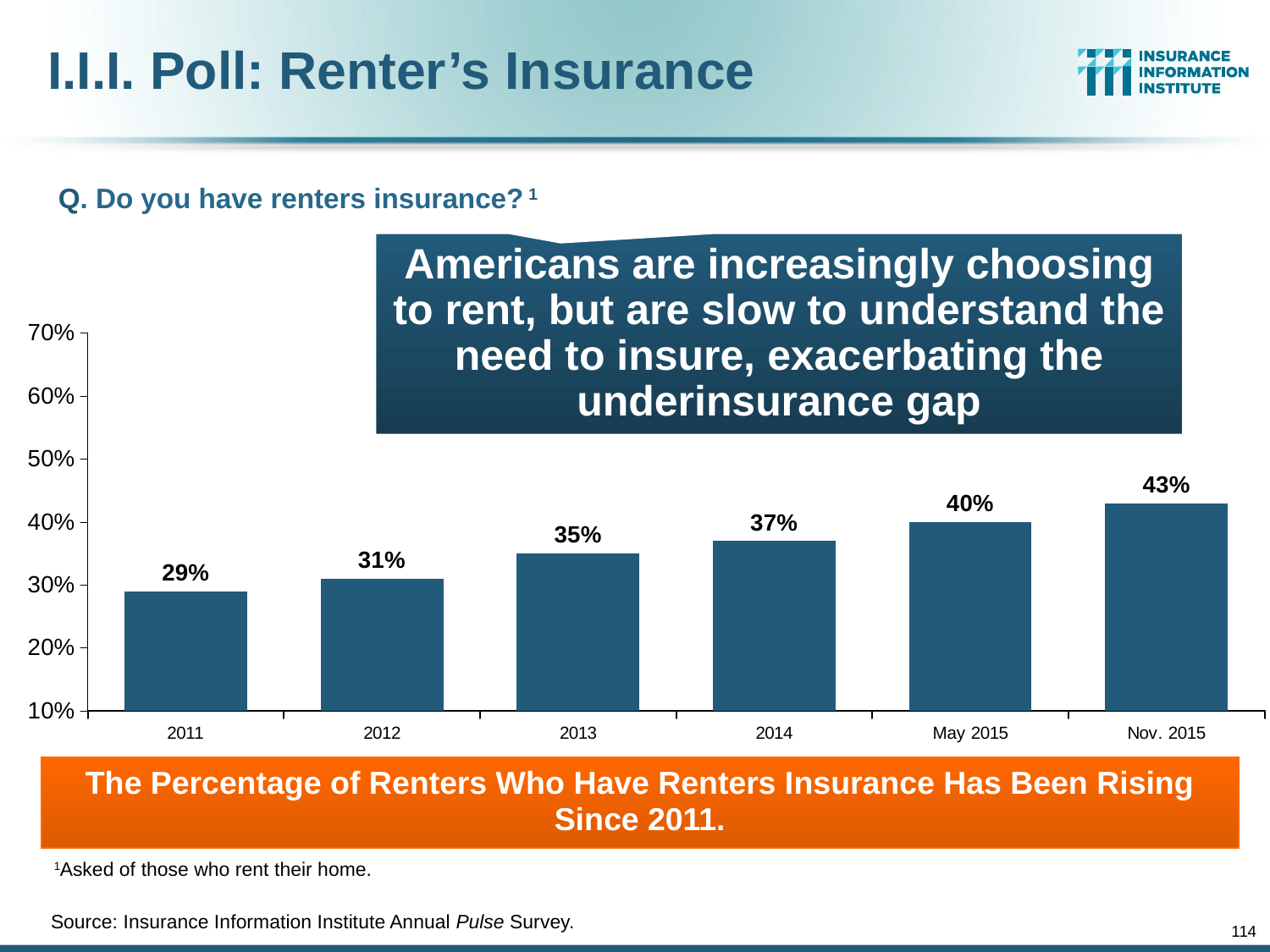
What is the difference between the Nov. 2015 value and the 2011 value? 14 percentage points What question was asked in the poll shown on the chart? Do you have renters insurance? Do the values rise or fall from 2011 to Nov. 2015? Rise What is the value shown for Nov. 2015? 43% What kind of chart is shown on the slide? Bar chart Which period has the highest percentage of renters with renters insurance? Nov. 2015 How many bars are shown in the chart? 6 What is the value shown for May 2015? 40% Is the value for 2012 greater or less than 40%? less Which is larger, the value for 2013 or the value for 2014? 2014 Which year has the lowest percentage of renters with renters insurance? 2011 What percentage of renters had renters insurance in 2011? 29%